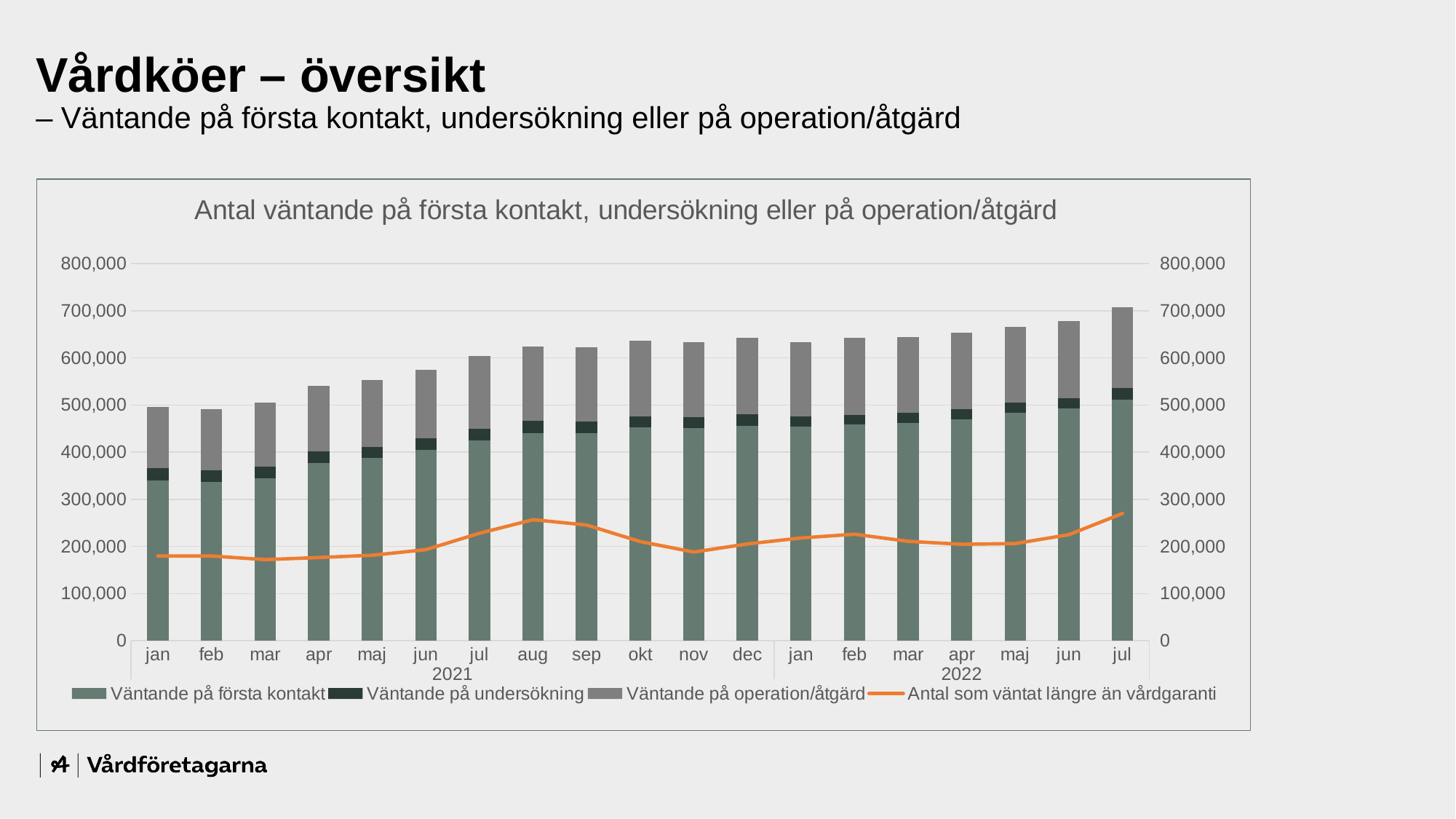
Which month has the highest total stacked bar? jul 2022 Is the total stacked bar for jun 2022 greater or less than 600,000? greater How many months are shown along the x axis of the chart? 19 Is the total stacked bar for jan 2021 greater or less than 600,000? less What kind of chart is shown on the slide? Stacked bar chart with a line Which has the larger total stacked bar, jan 2021 or jul 2022? jul 2022 How many series does the chart's legend list? 4 What is the title of the chart? Antal väntande på första kontakt, undersökning eller på operation/åtgärd Is the value of the 'Antal som väntat längre än vårdgaranti' line for jul 2022 greater or less than 200,000? greater Do the total stacked bars generally rise or fall from jan 2021 to jul 2022? rise Which series is drawn as an orange line in the chart? Antal som väntat längre än vårdgaranti